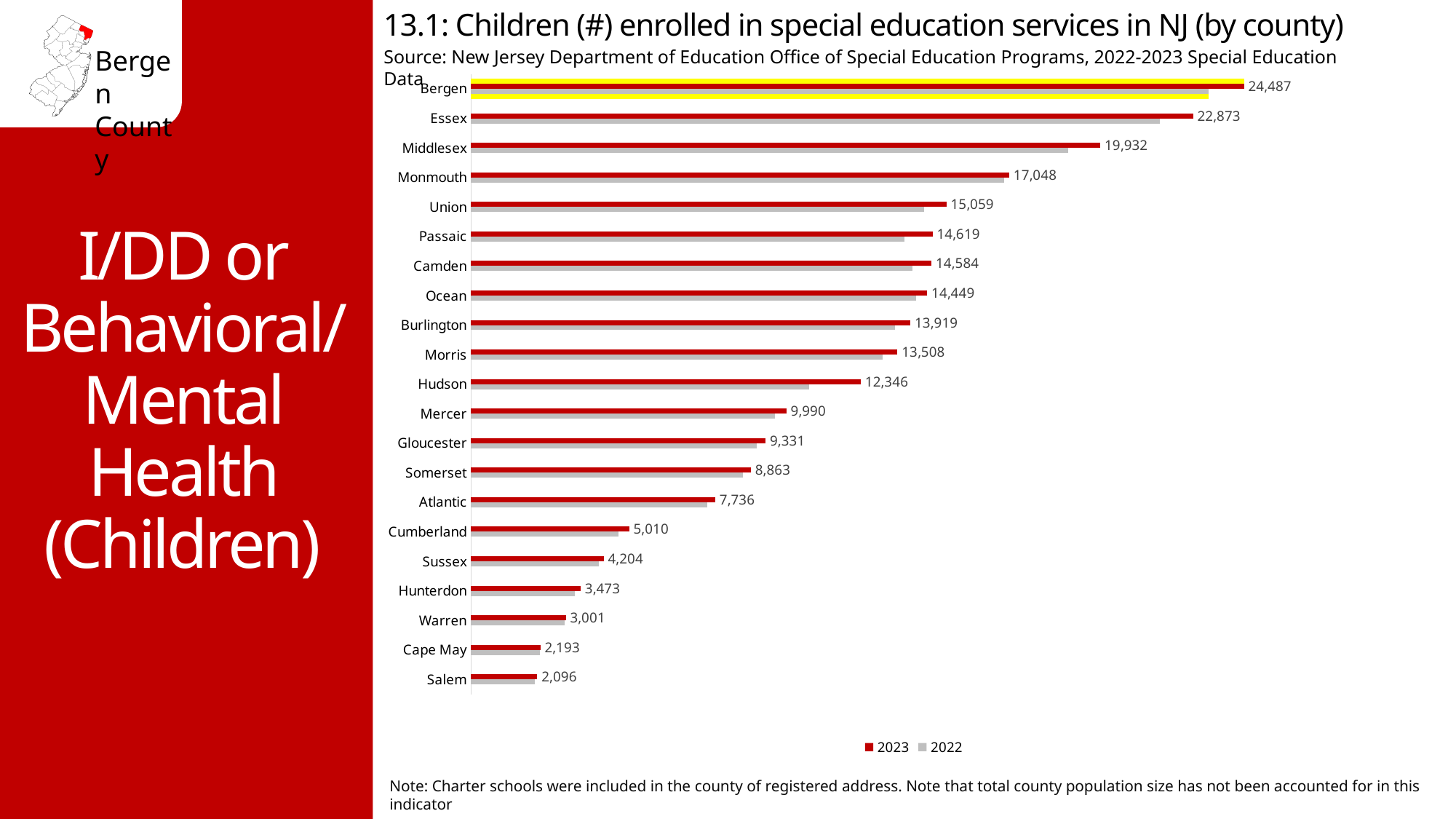
What is the 2023 value for Cape May? 2,193 Which has a larger 2023 value, Mercer or Gloucester? Mercer What kind of chart is shown on the slide? Bar chart What is the difference between the 2023 values for Cumberland and Sussex? 806 How many series does the legend list? 2 What is the difference between the 2023 values for Bergen and Essex? 1,614 Which county has the lowest 2023 value? Salem Which county has the highest 2023 value? Bergen What is the 2023 value for Bergen? 24,487 How many counties are shown on the chart? 21 Which series is shown in red in the legend? 2023 What is the 2023 value for Hudson? 12,346